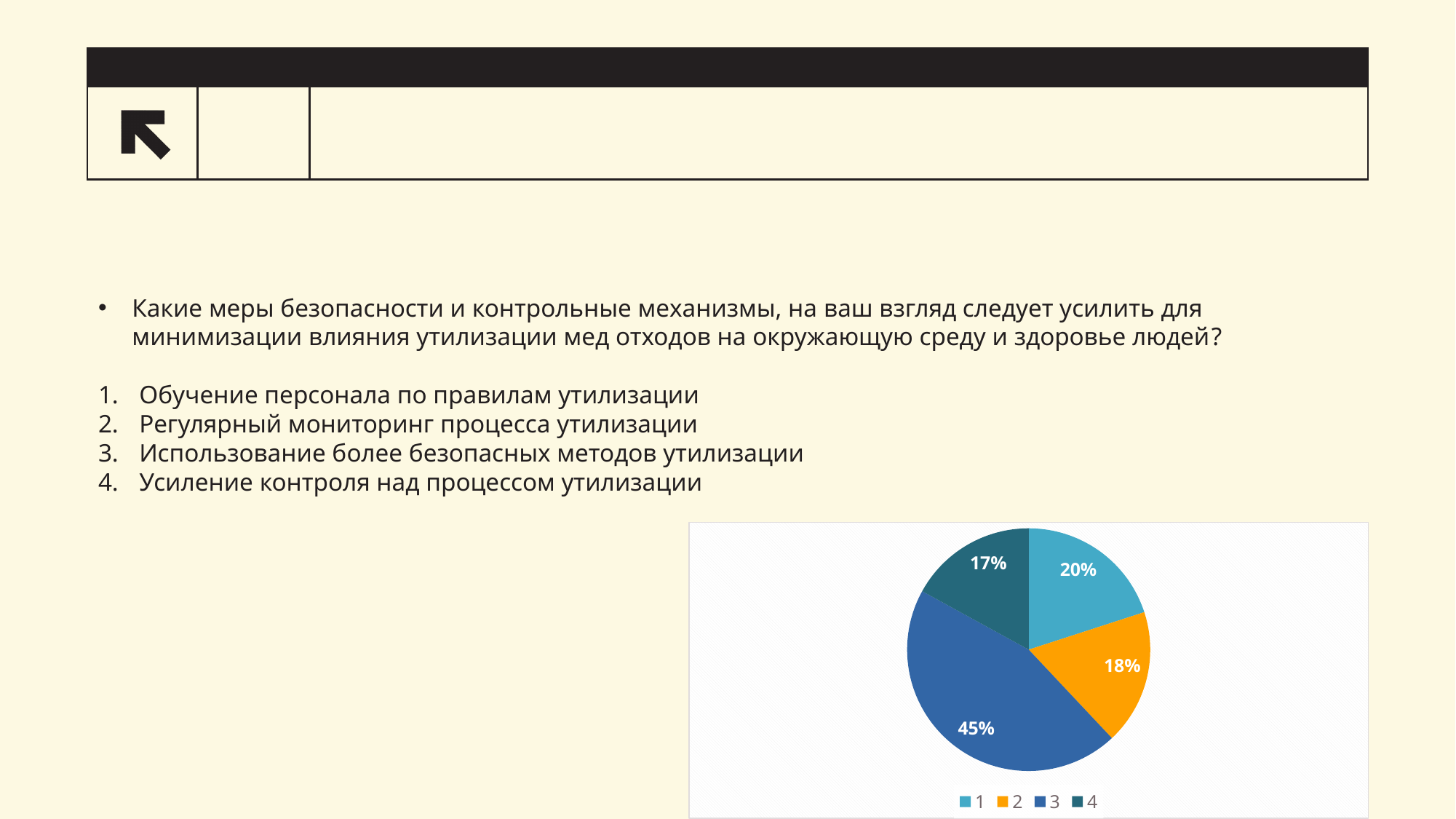
What share of the pie does category 2 have? 18% What is the difference in percentage points between category 3 and category 1? 25 What colour is the slice for category 2 in the pie chart? orange Which is larger, the slice for category 1 or the slice for category 2? 1 How many slices does the pie chart have? 4 What kind of chart is shown on the slide? pie chart What share of the pie does category 1 have? 20% Which category has the smallest slice of the pie? 4 Which category has the largest slice of the pie? 3 What share of the pie does category 3 have? 45% What share of the pie does category 4 have? 17% How many entries does the legend list? 4